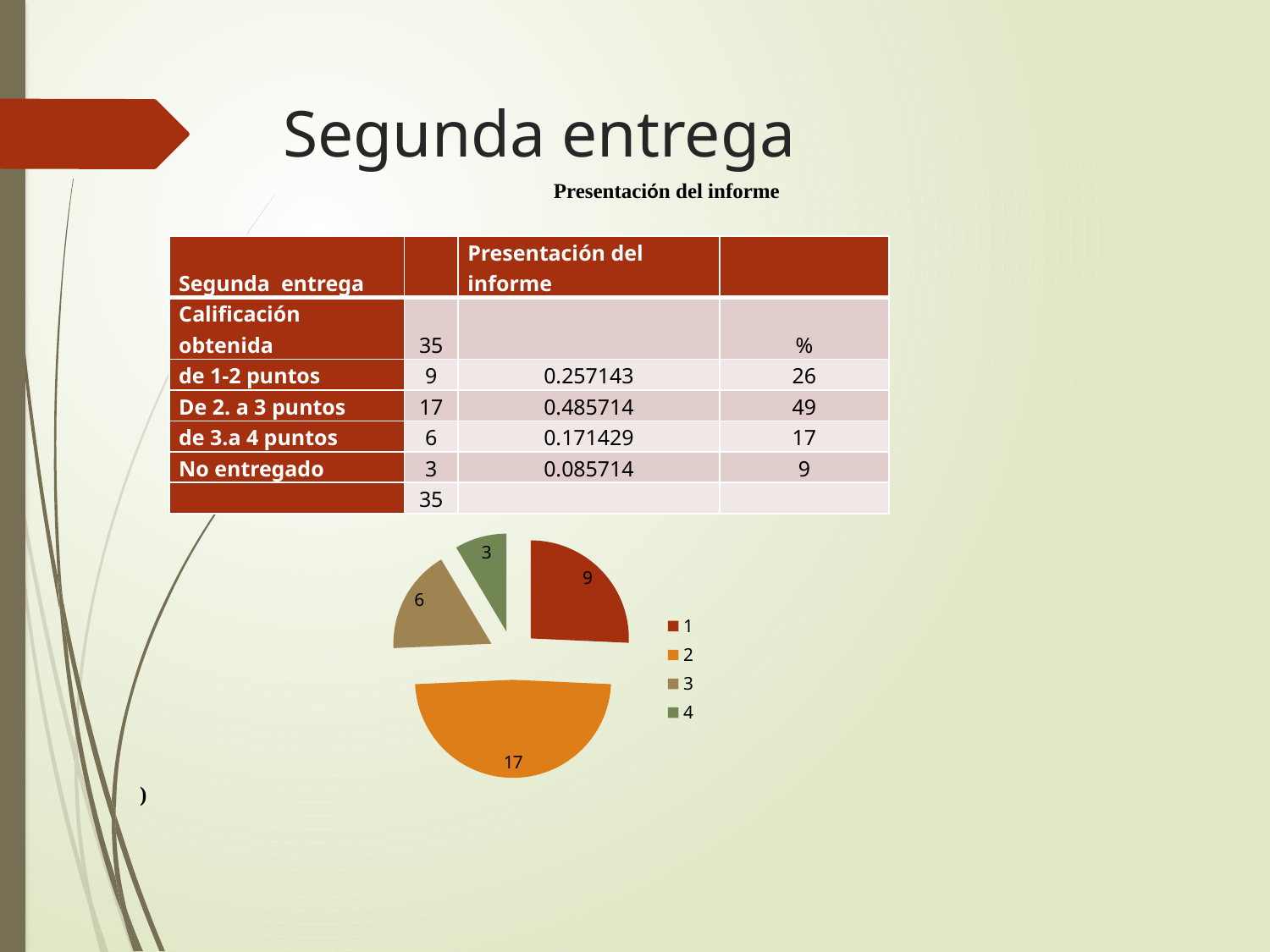
What is the value of slice 4 in the pie chart? 3 What is the total of all the slice values in the pie chart? 35 Which slice of the pie chart has the largest value? 2 How many slices does the pie chart have? 4 What is the value of slice 1 in the pie chart? 9 What is the value of slice 3 in the pie chart? 6 What kind of chart is shown on the slide? pie chart Which is larger in the pie chart, slice 3 or slice 4? 3 Which slice of the pie chart has the smallest value? 4 What colour is slice 2 in the pie chart? orange What is the value of slice 2 in the pie chart? 17 What is the difference between the values of slice 2 and slice 1 in the pie chart? 8